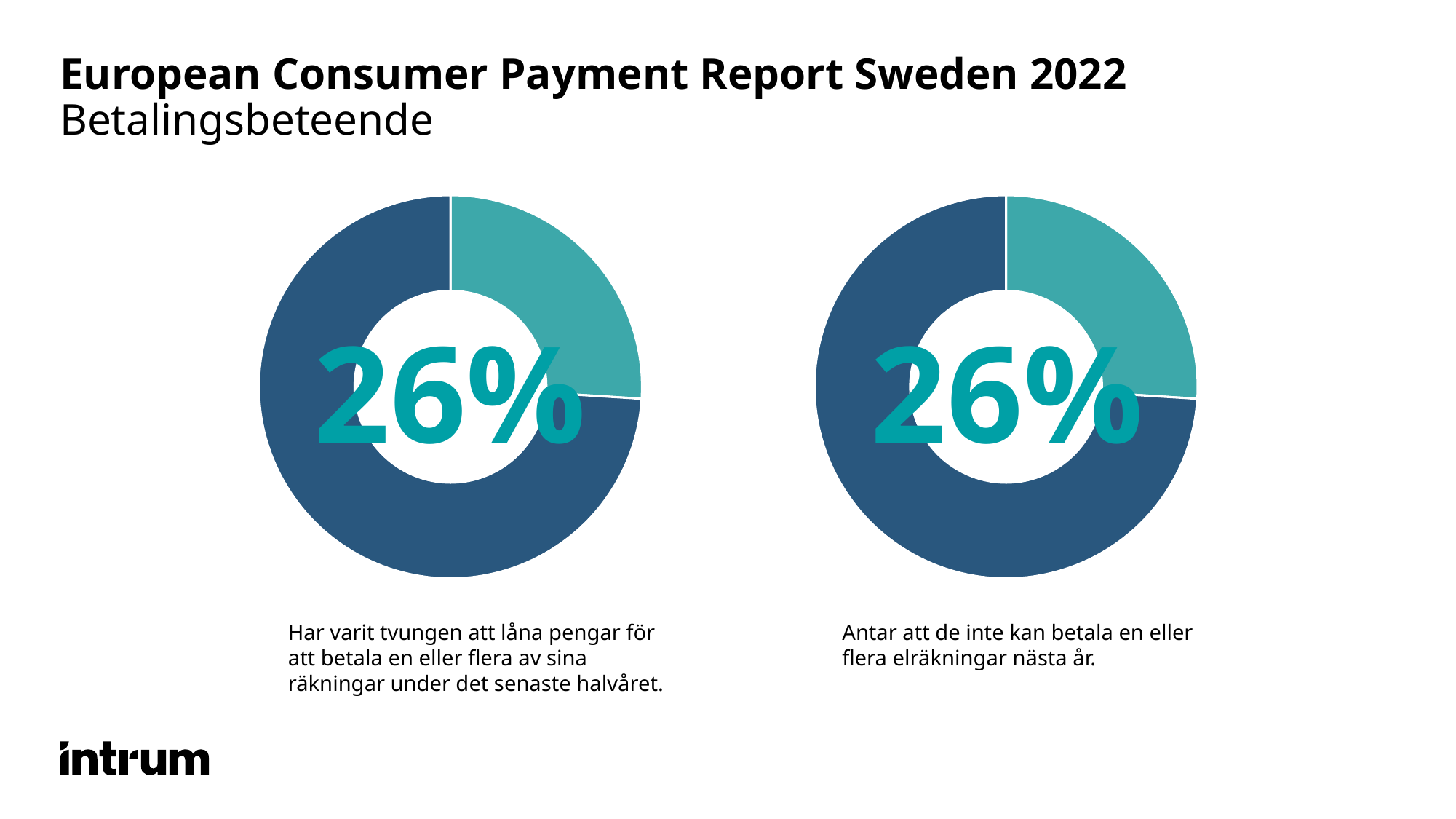
On the right chart, what share of the donut does the highlighted (teal) slice represent? 26% What kind of chart is used on the left side of the slide? Pie (donut) chart What colour is the slice representing the 26% on the right chart? Teal On the left chart, what share of the donut does the highlighted (teal) slice represent? 26% On the left chart, is the highlighted value greater or less than 50%? less How many charts are shown on the slide? 2 What is the difference between the percentage on the left chart and the percentage on the right chart? 0% On the left chart, what percentage of respondents have had to borrow money to pay one or more of their bills in the last six months? 26% Is the value shown on the left chart larger, smaller, or the same as the value shown on the right chart? The same What is the subtitle of the slide shown below the main title? Betalingsbeteende What kind of chart is used on the right side of the slide? Pie (donut) chart On the right chart, what percentage of respondents expect that they cannot pay one or more electricity bills next year? 26%